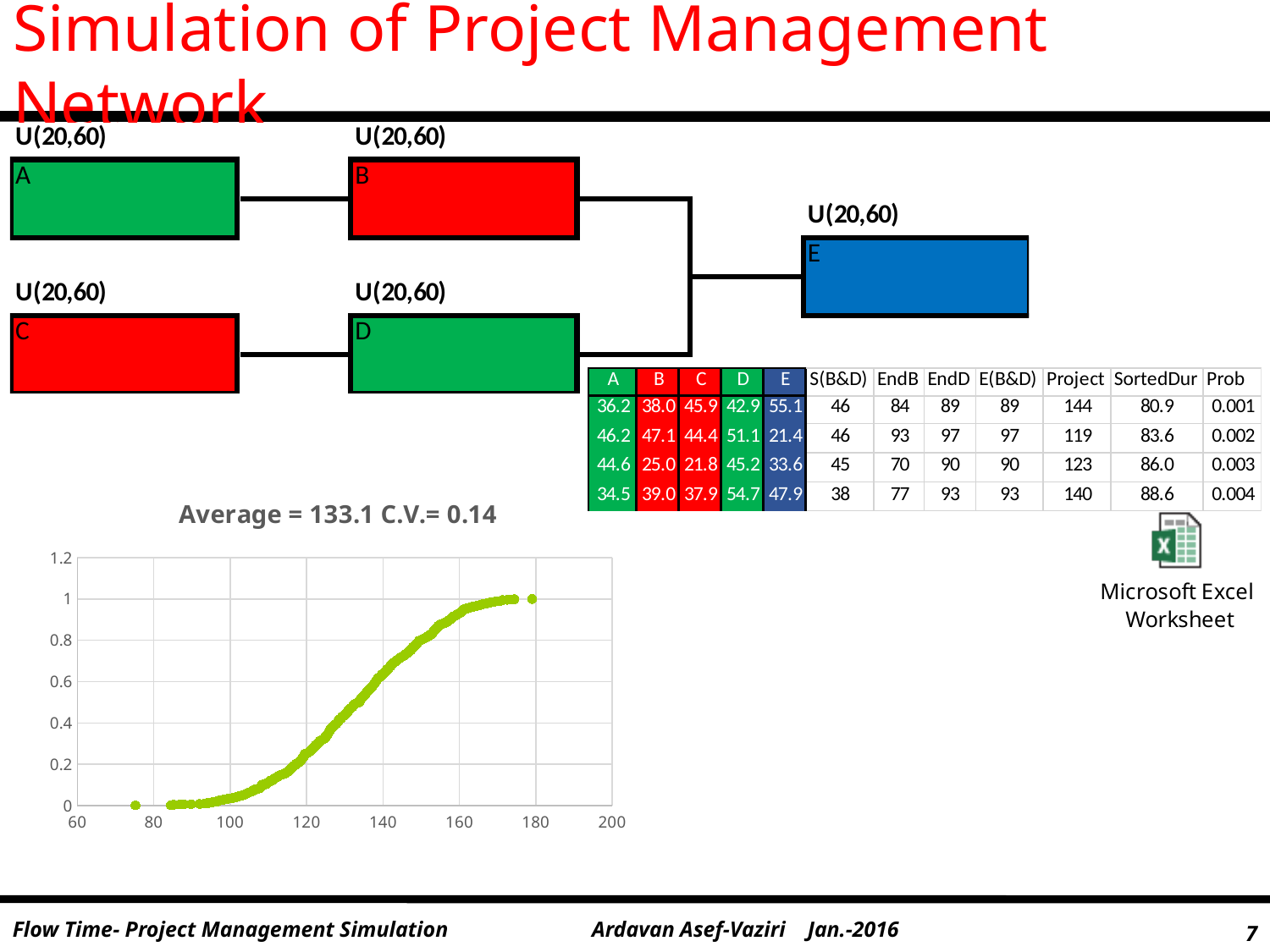
Is the plotted value at x = 120 greater or less than 0.4? less What is the title of the chart? Average = 133.1 C.V.= 0.14 Do the plotted values rise or fall as the x axis increases from 60 to 200? rise What is the highest value the plotted points reach on the y axis? 1 What is the largest tick value shown on the x axis? 200 Which is larger, the plotted value at x = 140 or the plotted value at x = 100? x = 140 Is the plotted value at x = 100 greater or less than 0.2? less What kind of chart is shown on the slide? scatter chart Is the plotted value at x = 180 greater or less than 0.6? greater